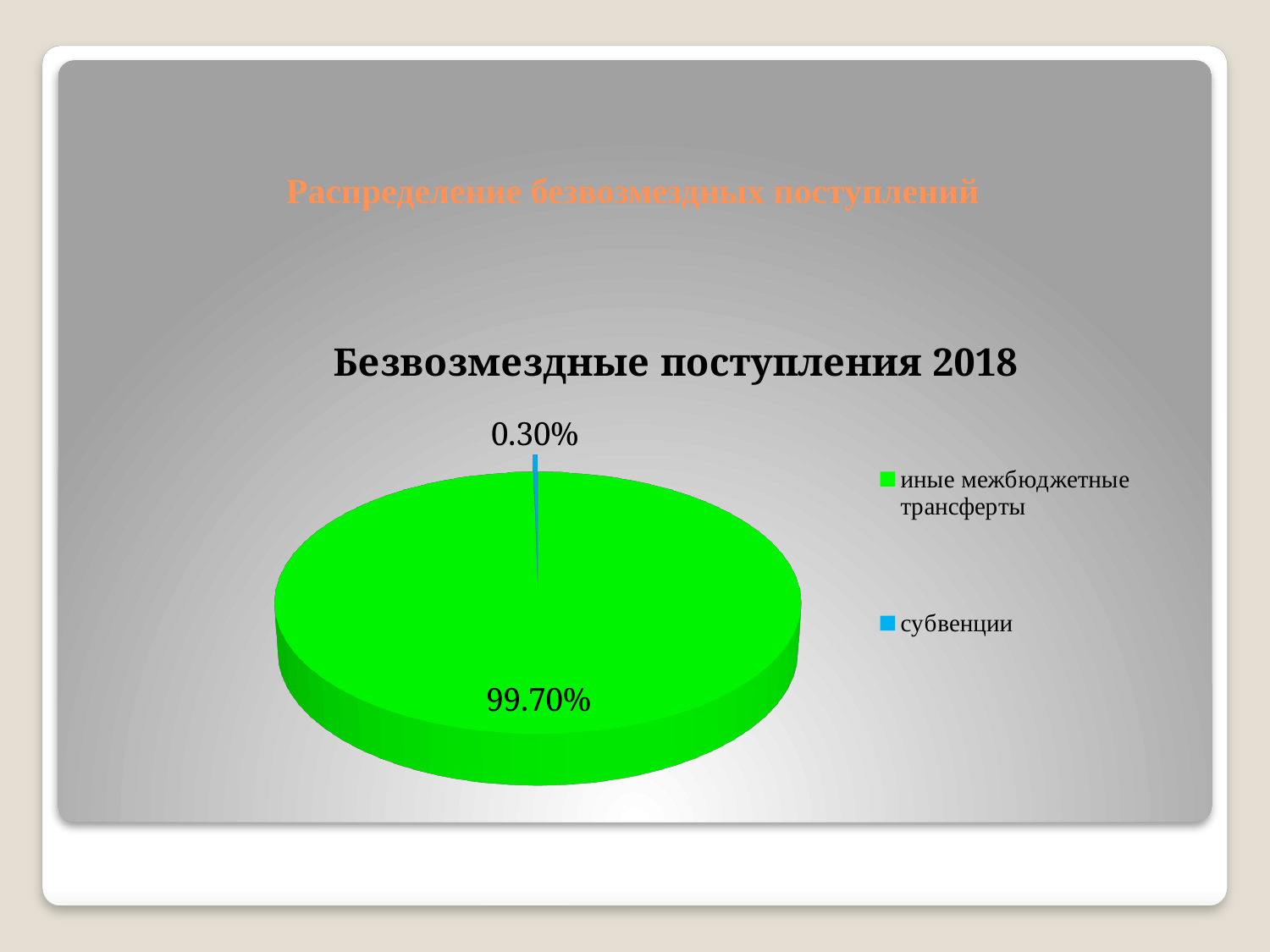
What kind of chart is shown on the slide? pie chart What is the title of the chart? Безвозмездные поступления 2018 How many categories does the legend list? 2 Which category has the largest slice of the pie? иные межбюджетные трансферты What share of the pie is labelled for иные межбюджетные трансферты? 99.70% Which is larger: the share for субвенции or the share for иные межбюджетные трансферты? иные межбюджетные трансферты What colour is the slice for иные межбюджетные трансферты? green What share of the pie is labelled for субвенции? 0.30% Which category has the smallest slice of the pie? субвенции What is the difference in percentage points between the share for иные межбюджетные трансферты and the share for субвенции? 99.40%